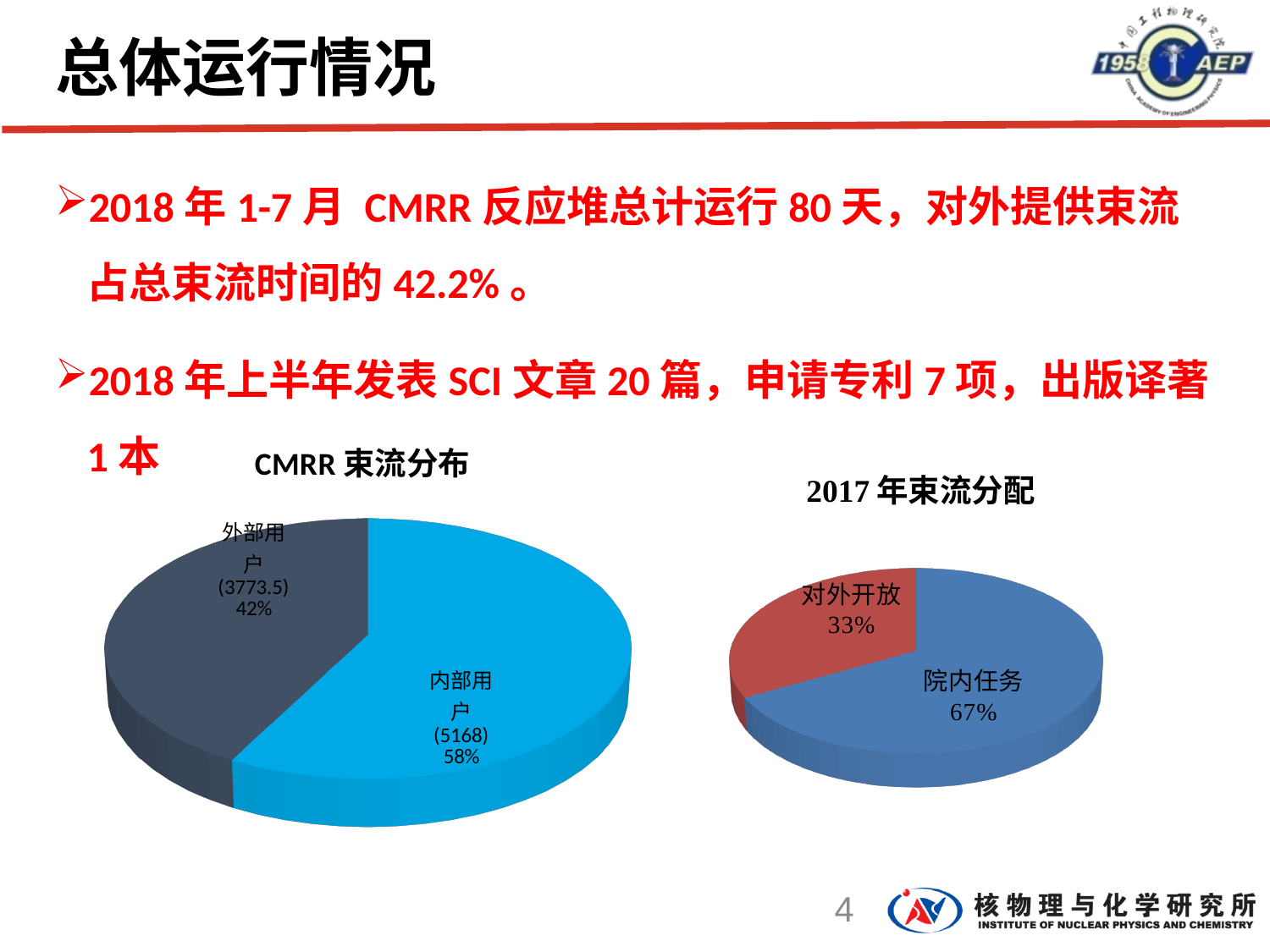
In the 'CMRR 束流分布' chart, what share of the pie does 外部用户 take? 42% In the 'CMRR 束流分布' chart, which slice is larger, 内部用户 or 外部用户? 内部用户 In the 'CMRR 束流分布' chart, what share of the pie does 内部用户 take? 58% In the '2017 年束流分配' chart, which slice is the largest? 院内任务 In the 'CMRR 束流分布' chart, what value is shown for 内部用户? 5168 What is the title of the pie chart on the right of the slide? 2017 年束流分配 What kind of chart is the 'CMRR 束流分布' chart on the left? pie chart In the 'CMRR 束流分布' chart, what value is shown for 外部用户? 3773.5 In the '2017 年束流分配' chart, what share of the pie does 对外开放 take? 33% In the 'CMRR 束流分布' chart, what is the difference between the 内部用户 value and the 外部用户 value? 1394.5 How many slices does the 'CMRR 束流分布' chart have? 2